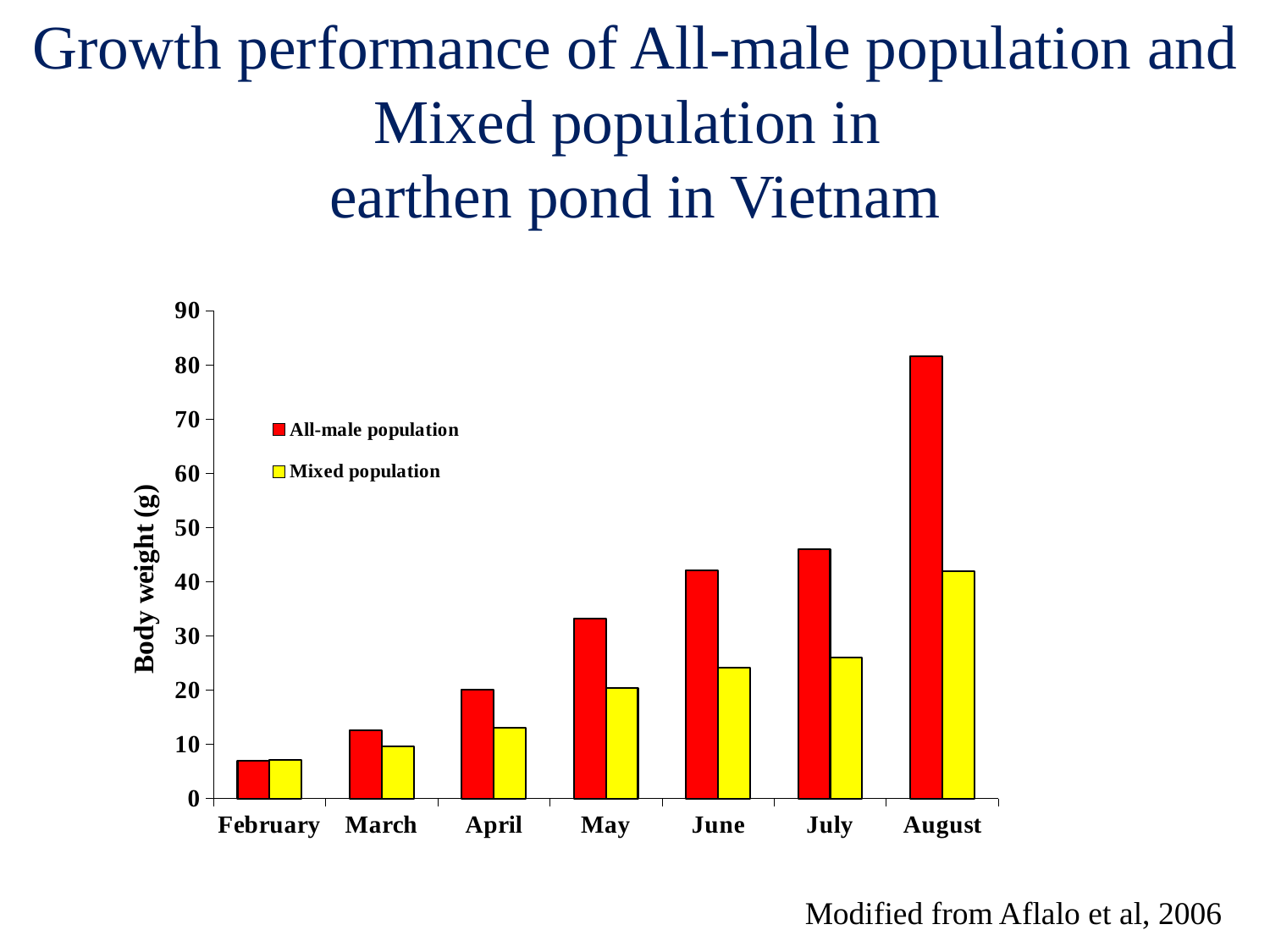
Do the All-male population body weights rise or fall from February to August? Rise In July, which series has the larger body weight, All-male population or Mixed population? All-male population How many months are shown on the x axis? 7 Is the All-male population value for August greater or less than 70? greater Is the All-male population value for July greater or less than 50? less In which month is the Mixed population body weight lowest? February How many series does the legend list? 2 What is the label on the y axis? Body weight (g) What kind of chart is shown on the slide? Bar chart In which month is the All-male population body weight highest? August Is the Mixed population value for August greater or less than 30? greater